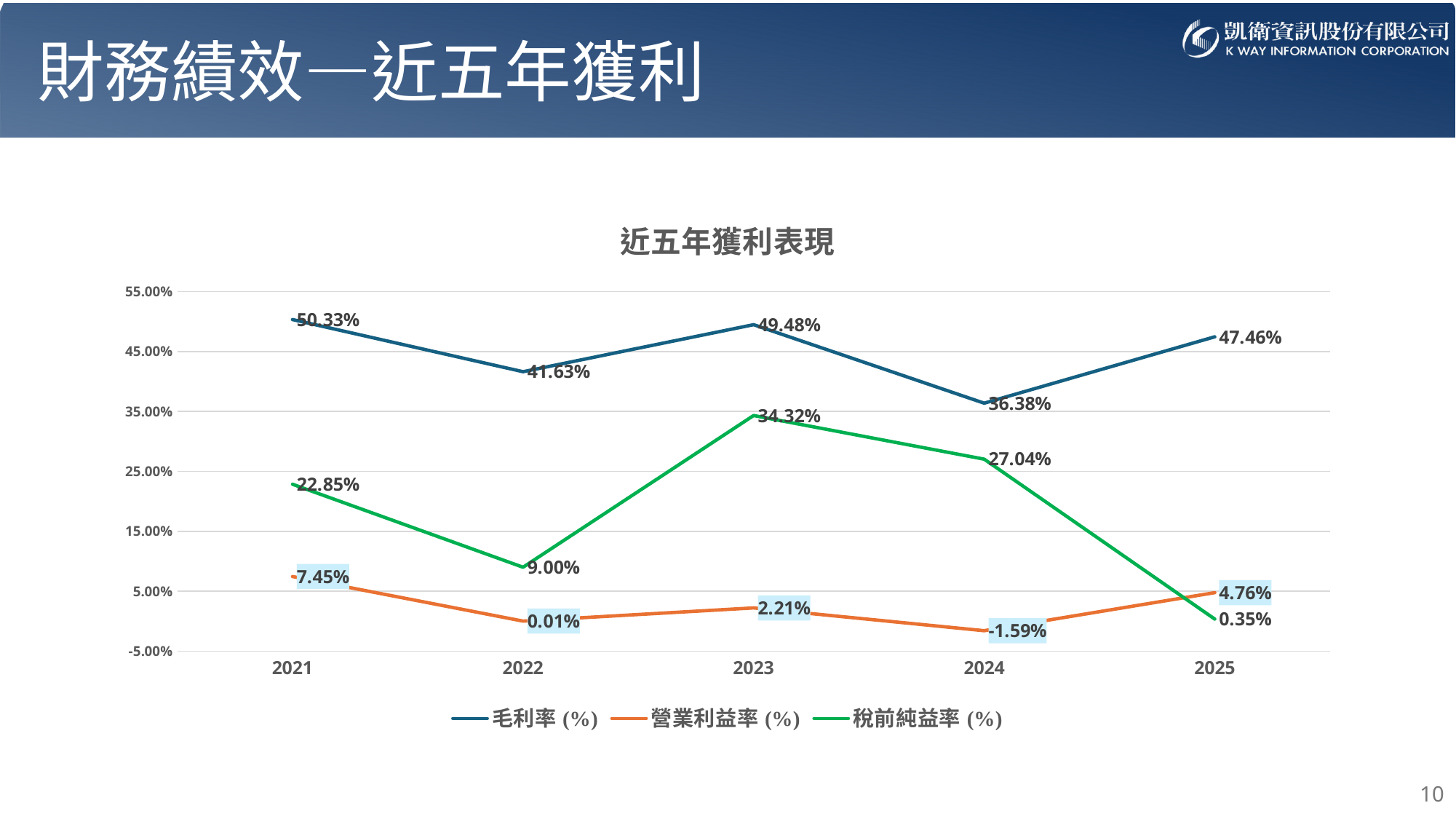
What is the title of the chart? 近五年獲利表現 In which year is 毛利率 (%) lowest? 2024 What is the 營業利益率 (%) value for 2024? -1.59% What is the difference between the 毛利率 (%) values for 2021 and 2022? 8.70% How many years are plotted on the x axis? 5 What is the 毛利率 (%) value for 2021? 50.33% In which year is 稅前純益率 (%) highest? 2023 Does 稅前純益率 (%) rise or fall from 2023 to 2025? fall Which is larger in 2025: 營業利益率 (%) or 稅前純益率 (%)? 營業利益率 (%) How many series does the legend list? 3 What is the 稅前純益率 (%) value for 2023? 34.32% What kind of chart is shown on the slide? line chart